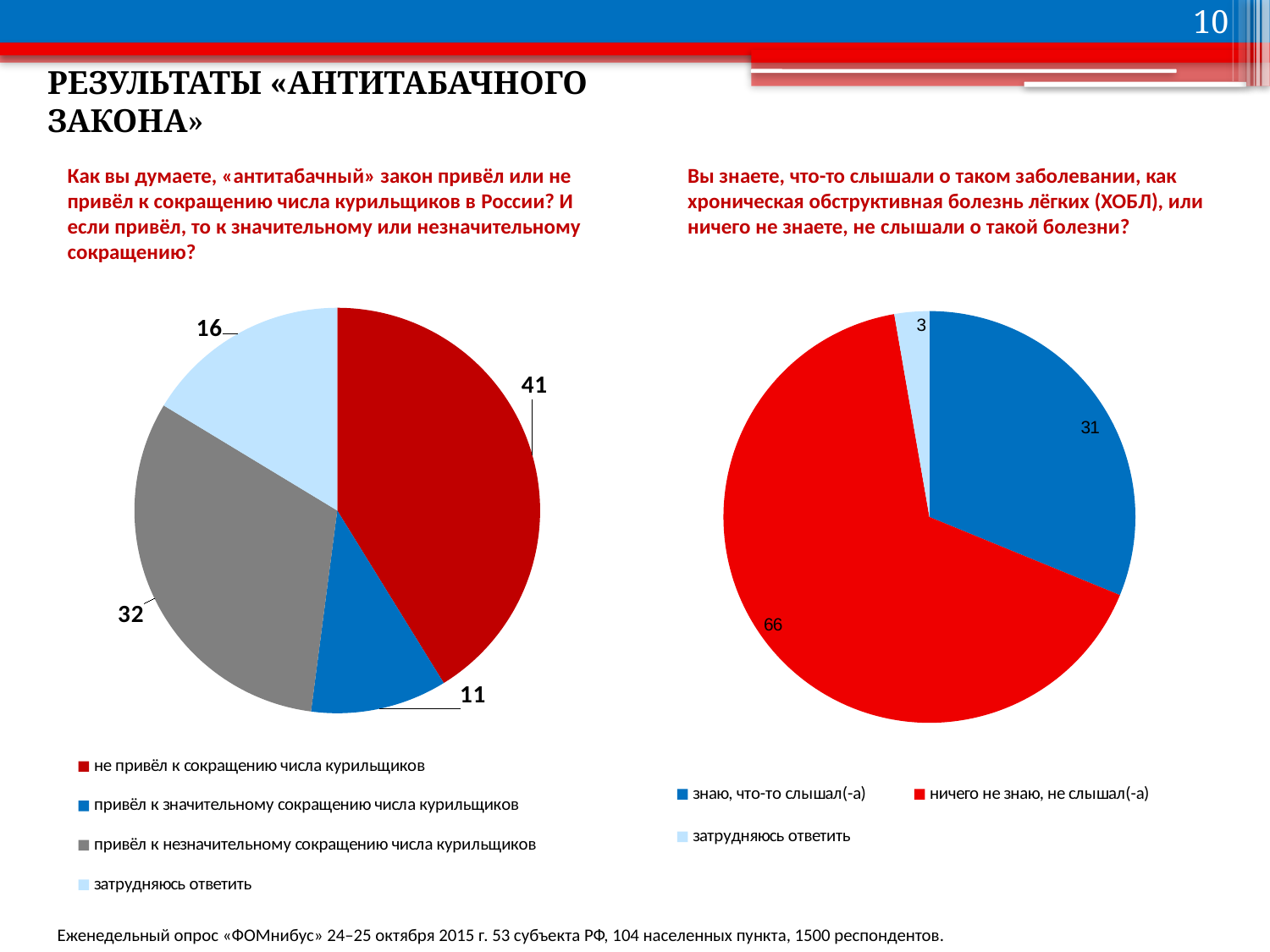
On the right pie chart, what is the value for «ничего не знаю, не слышал(-а)»? 66 On the right pie chart, which category has the largest slice? ничего не знаю, не слышал(-а) On the right pie chart, which is larger: «знаю, что-то слышал(-а)» or «ничего не знаю, не слышал(-а)»? ничего не знаю, не слышал(-а) On the left pie chart, what is the difference between «не привёл к сокращению числа курильщиков» and «привёл к незначительному сокращению числа курильщиков»? 9 On the left pie chart, how many categories does the legend list? 4 On the left pie chart, which category has the smallest slice? привёл к значительному сокращению числа курильщиков On the left pie chart, what is the value for «привёл к незначительному сокращению числа курильщиков»? 32 On the left pie chart, what is the value for «привёл к значительному сокращению числа курильщиков»? 11 On the right pie chart, what is the value for «знаю, что-то слышал(-а)»? 31 On the left pie chart, what is the value for «не привёл к сокращению числа курильщиков»? 41 On the right pie chart, what is the value for «затрудняюсь ответить»? 3 What type of chart is shown on the right side of the slide? pie chart